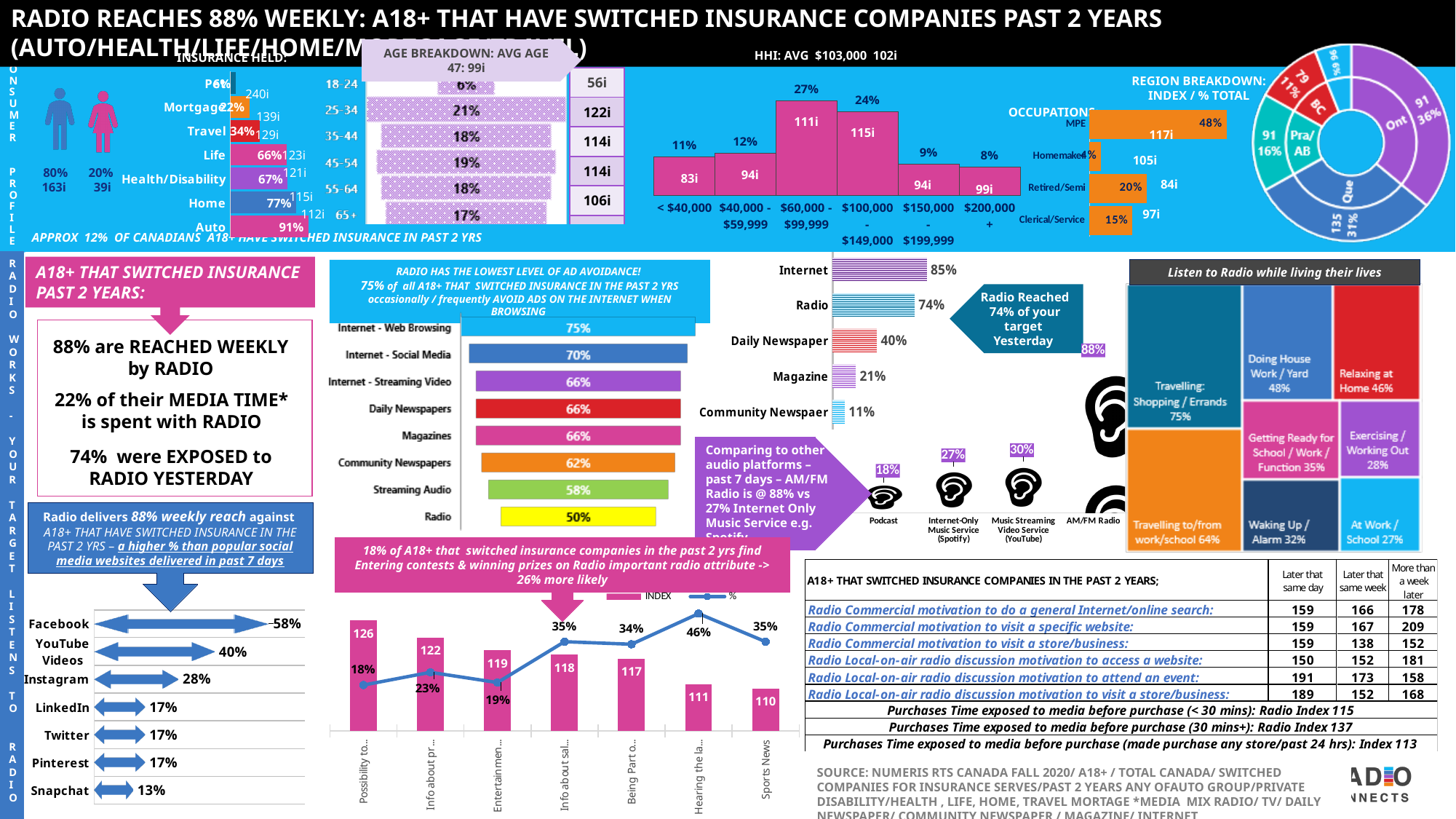
In the social media chart at the bottom left (Facebook, YouTube Videos, Instagram, etc.), which category has the lowest value? Snapchat In the 'exposed yesterday' bar chart (centre-right, Internet/Radio/Daily Newspaper/Magazine/Community Newspaper), what is the value for Daily Newspaper? 40% In the ad avoidance bar chart (centre of the slide, 'RADIO HAS THE LOWEST LEVEL OF AD AVOIDANCE!'), what is the value for Radio? 50% In the 'INSURANCE HELD' bar chart at the top left, what percentage is shown for Auto? 91% In the household income (HHI) bar chart at the top centre, what is the index value for the $100,000 - $149,000 bracket? 115i In the ad avoidance bar chart (centre of the slide), what is the difference between Internet - Social Media and Radio? 20% In the ad avoidance bar chart (centre of the slide), which category has the highest value? Internet - Web Browsing In the audio platforms chart (Podcast, Internet-Only Music Service, Music Streaming Video Service, AM/FM Radio), which is larger: Podcast or Music Streaming Video Service (YouTube)? Music Streaming Video Service (YouTube) In the radio attributes chart at the bottom centre (INDEX bars with % line), what is the INDEX value for Sports News? 110 In the household income (HHI) bar chart at the top centre, which income bracket has the highest percentage? $60,000 - $99,999 In the 'exposed yesterday' bar chart (centre-right), how many categories are shown? 5 In the social media chart at the bottom left, what is the value for YouTube Videos? 40%